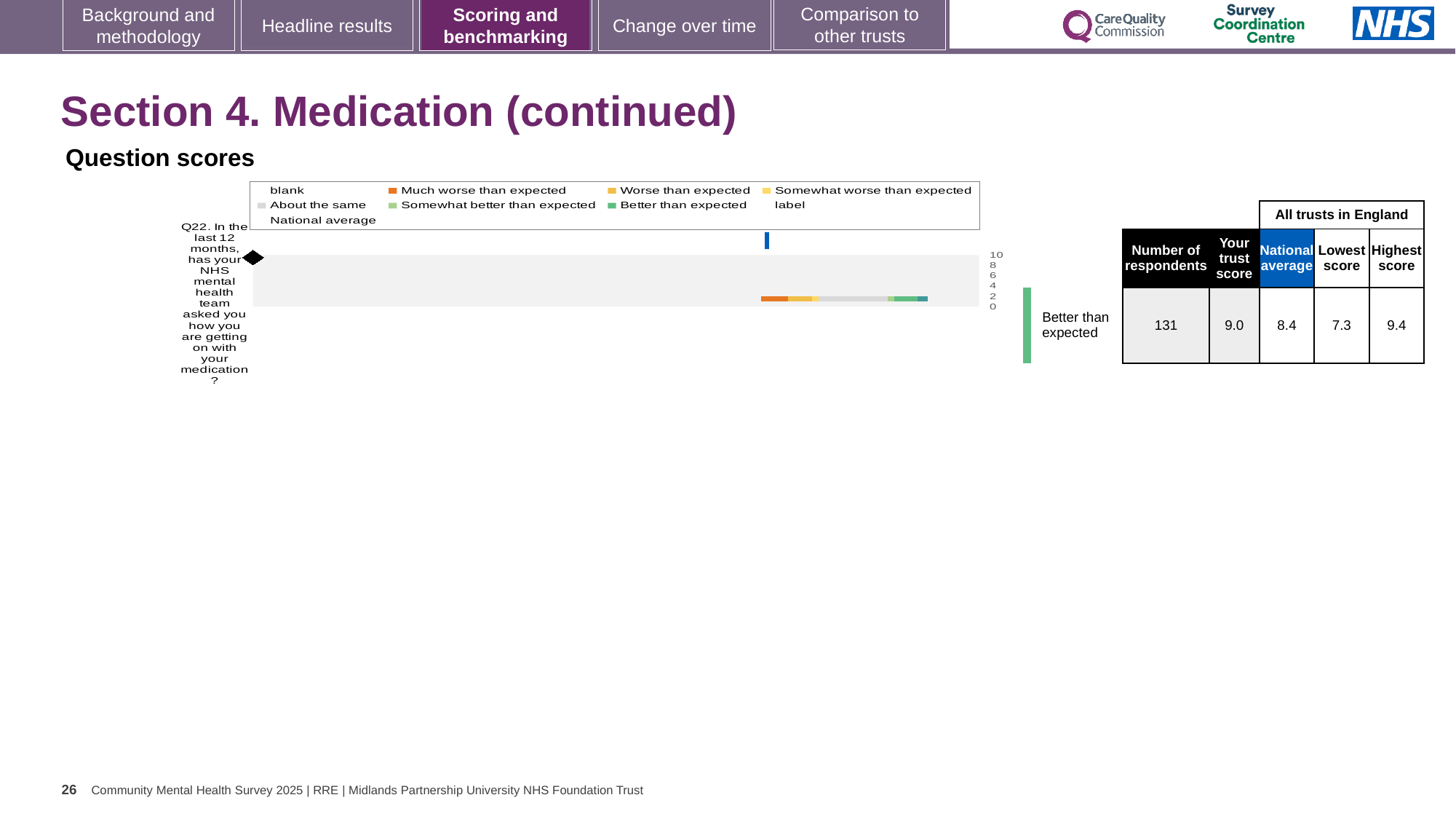
What is the lowest score among all trusts in England for Q22? 7.3 Which is larger for Q22, the trust's score or the national average? the trust's score What is the trust's score for Q22 shown in the table next to the chart? 9.0 What is the difference between the highest and lowest scores for Q22 across all trusts in England? 2.1 What kind of chart is used to show the Q22 question score? bar chart How many respondents answered Q22? 131 What is the national average score for Q22? 8.4 What is the maximum value shown on the chart's score axis? 10 By how much does the trust's Q22 score exceed the national average? 0.6 What is the highest score among all trusts in England for Q22? 9.4 Which benchmark category is the trust's Q22 score placed in? Better than expected How many survey questions are plotted on the chart? 1